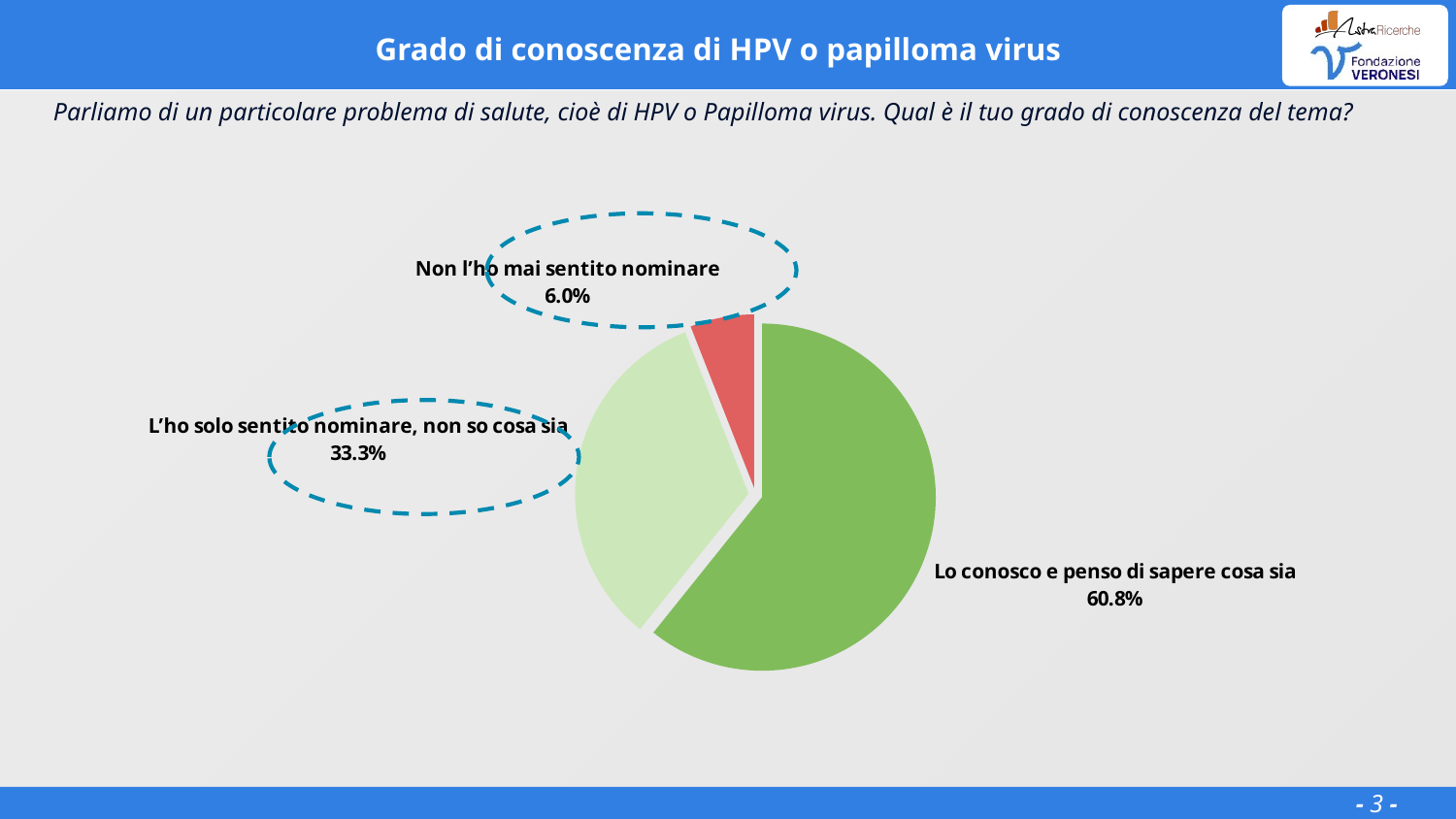
Which response has the smallest slice of the pie? Non l'ho mai sentito nominare What is the difference in percentage points between "L'ho solo sentito nominare, non so cosa sia" and "Non l'ho mai sentito nominare"? 27.3 Which response has the largest slice of the pie? Lo conosco e penso di sapere cosa sia What kind of chart is shown on the slide? pie chart How many slices does the pie chart have? 3 What is the title of the slide containing the pie chart? Grado di conoscenza di HPV o papilloma virus What is the difference in percentage points between "Lo conosco e penso di sapere cosa sia" and "L'ho solo sentito nominare, non so cosa sia"? 27.5 What share of respondents answered "Non l'ho mai sentito nominare"? 6.0% Which is larger: the share for "L'ho solo sentito nominare, non so cosa sia" or for "Non l'ho mai sentito nominare"? L'ho solo sentito nominare, non so cosa sia What share of respondents answered "Lo conosco e penso di sapere cosa sia"? 60.8% What share of respondents answered "L'ho solo sentito nominare, non so cosa sia"? 33.3% What colour is the slice for "Non l'ho mai sentito nominare"? red